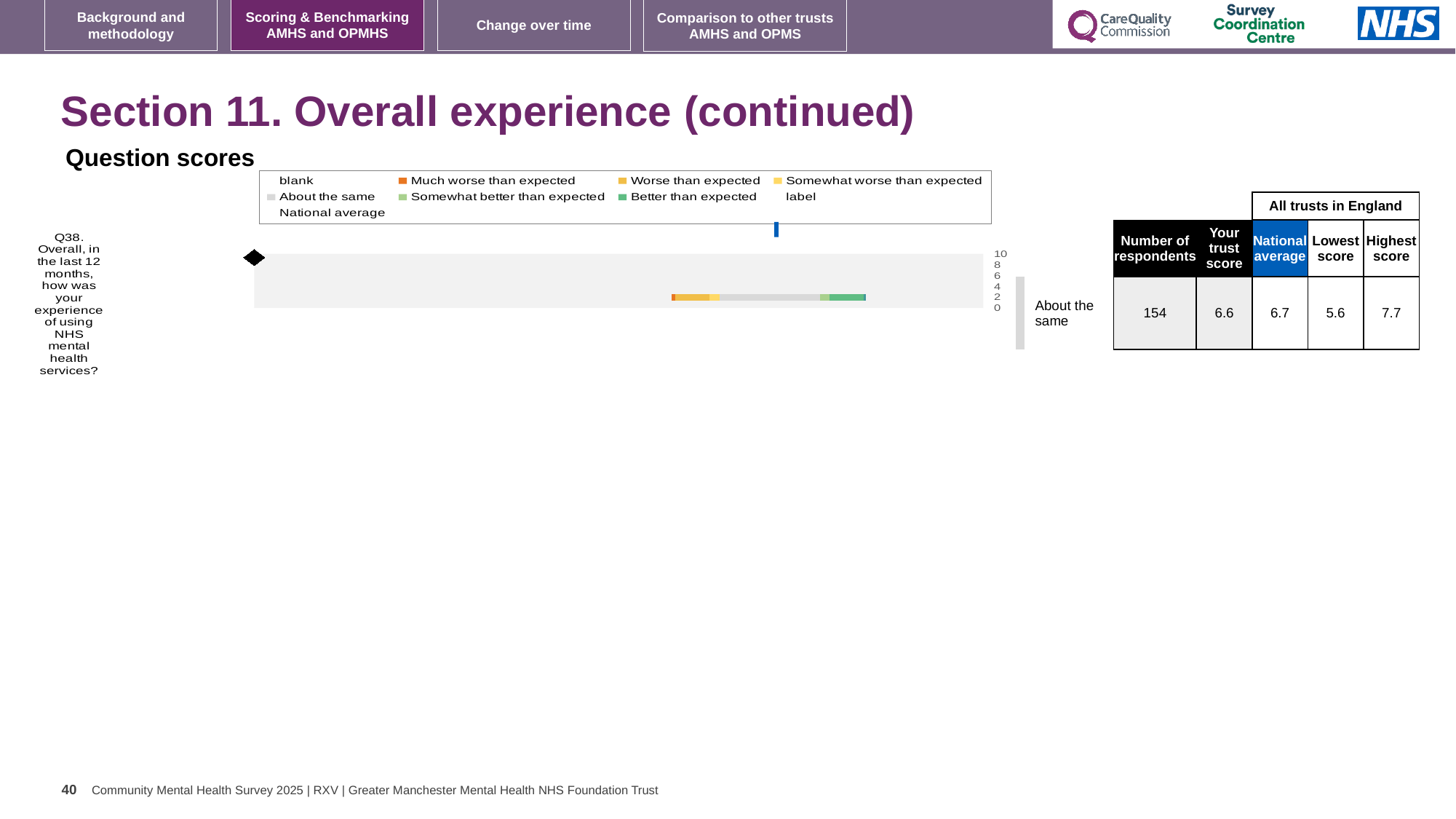
What is the lowest score among all trusts in England for Q38? 5.6 Which is larger for Q38, the trust score or the national average? national average What is the national average for Q38 as shown in the table next to the chart? 6.7 What category label is shown to the right of the bar for Q38? About the same Which legend entry is shown in orange in the Question scores chart? Much worse than expected How many survey questions are plotted in the Question scores chart? 1 Which question is plotted in the Question scores chart? Q38. Overall, in the last 12 months, how was your experience of using NHS mental health services? How many respondents answered Q38? 154 What is the highest score among all trusts in England for Q38? 7.7 What is the trust's score for Q38 as shown in the table next to the chart? 6.6 What kind of chart is shown under 'Question scores'? bar chart What is the difference between the highest score and the lowest score for Q38? 2.1